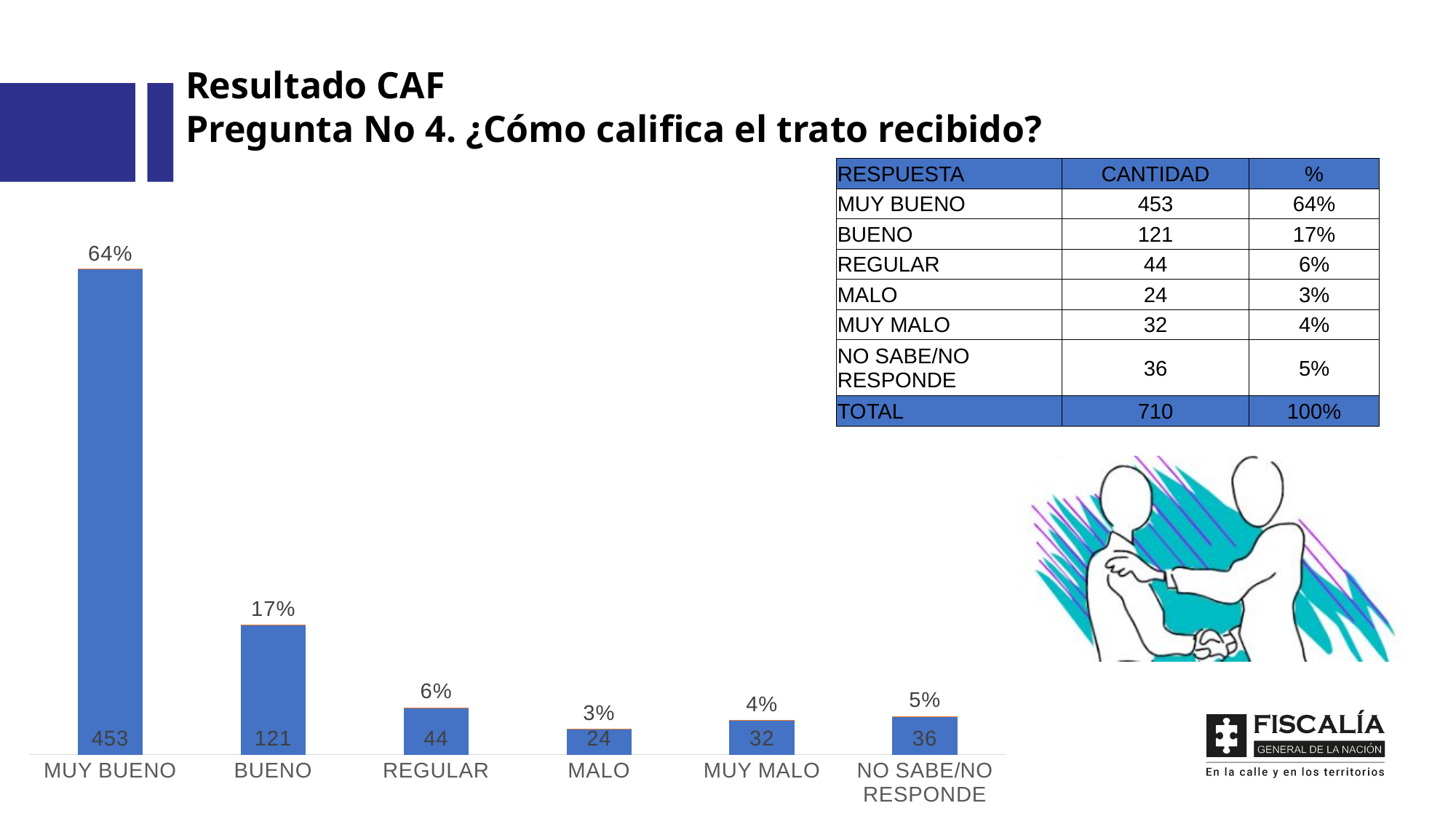
Which category has the lowest bar in the chart? MALO Which category has the highest bar in the chart? MUY BUENO Which has a larger count, MUY MALO or NO SABE/NO RESPONDE? NO SABE/NO RESPONDE What percentage is shown above the BUENO bar? 17% What is the count shown for REGULAR in the bar chart? 44 What is the difference in count between MUY BUENO and BUENO? 332 What kind of chart is shown on the slide? Bar chart What is the total count shown in the table for all responses? 710 What is the difference in percentage points between REGULAR and MALO? 3% What is the count (cantidad) shown for MUY BUENO in the bar chart? 453 How many categories are shown on the x axis of the bar chart? 6 What percentage is shown for NO SABE/NO RESPONDE? 5%